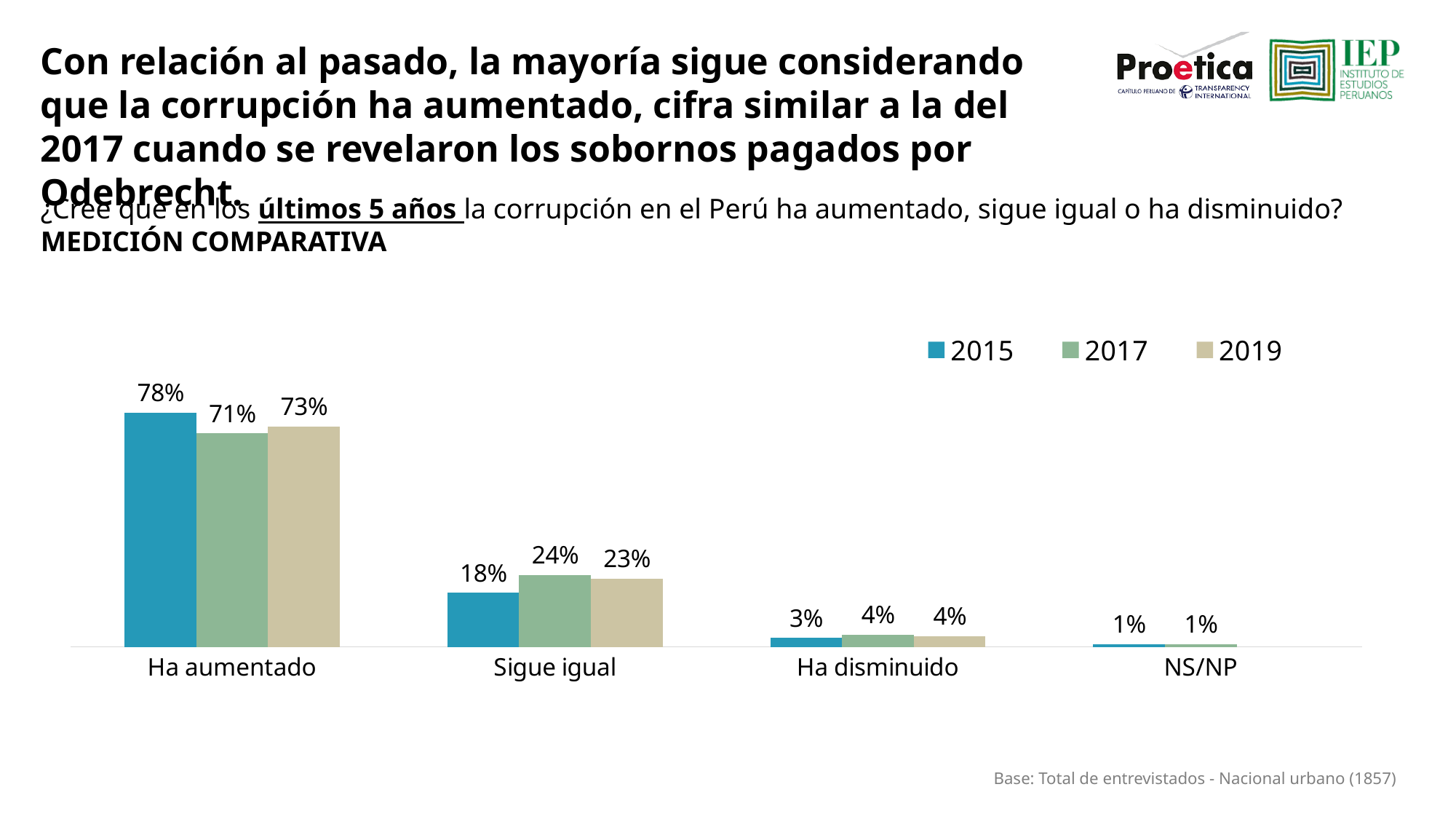
Which category has the highest value in the 2019 series? Ha aumentado What is the value for 'NS/NP' in the 2015 series? 1% Which years are listed in the legend? 2015, 2017, 2019 How many categories are shown on the x axis? 4 How many series does the legend list? 3 Which is larger for 'Sigue igual': the 2015 value or the 2019 value? 2019 What is the value for 'Sigue igual' in the 2017 series? 24% What kind of chart is shown on the slide? Bar chart What is the difference between the 2015 and 2017 values for 'Ha aumentado'? 7 percentage points Which category has the lowest value in the 2017 series? NS/NP What is the value for 'Ha disminuido' in the 2019 series? 4% What is the value for 'Ha aumentado' in the 2015 series? 78%